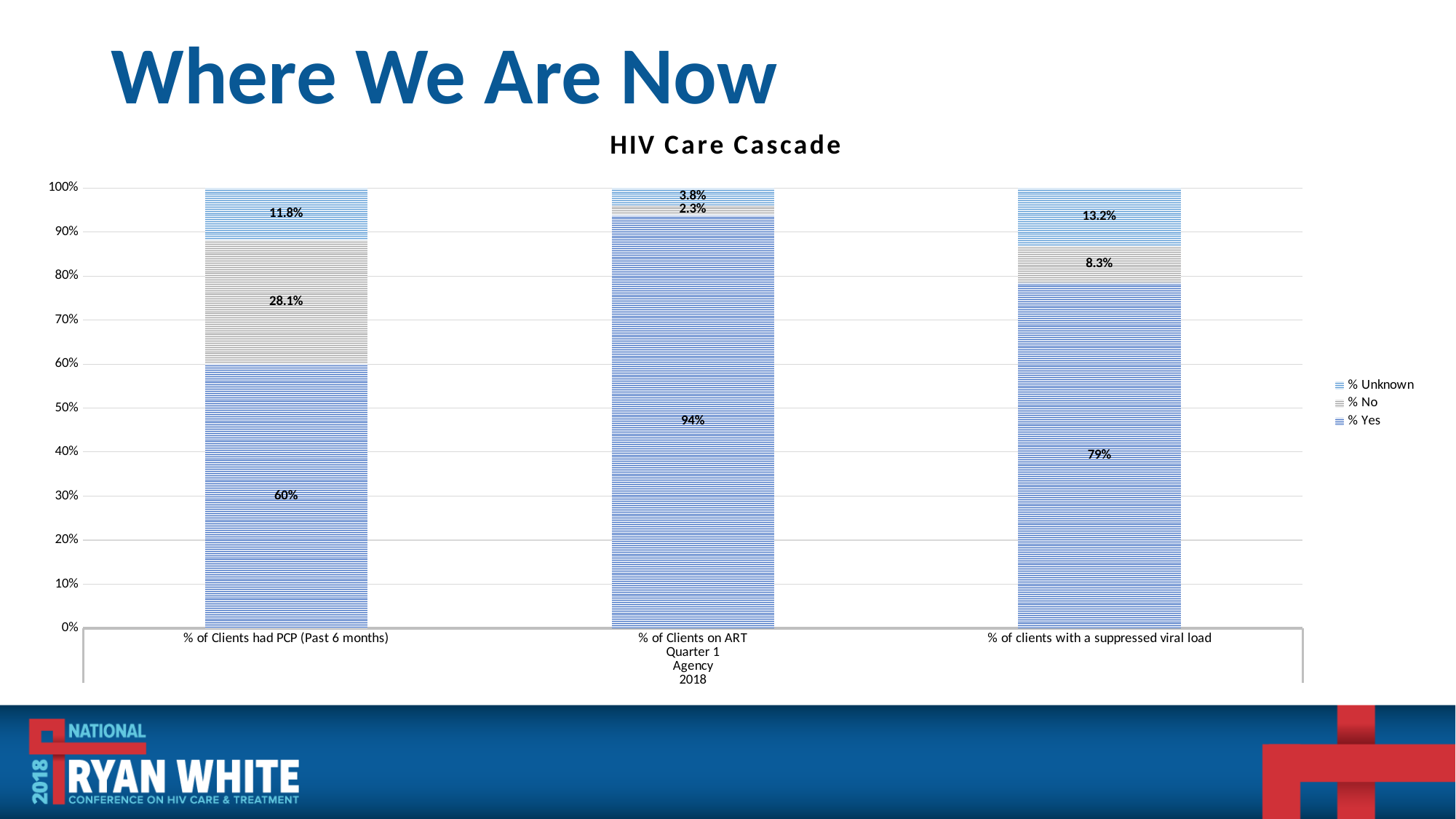
What is the % Unknown value for '% of clients with a suppressed viral load'? 13.2% How many categories are shown on the x axis? 3 What is the difference between the % Yes values for '% of Clients on ART' and '% of Clients had PCP (Past 6 months)'? 34% What is the title of the chart? HIV Care Cascade What is the % Yes value for '% of Clients on ART'? 94% Which category has the highest % Yes value? % of Clients on ART Which is larger: the % No value for '% of clients with a suppressed viral load' or the % No value for '% of Clients had PCP (Past 6 months)'? % of Clients had PCP (Past 6 months) Which category has the lowest % No value? % of Clients on ART How many series does the legend list? 3 What is the % No value for '% of Clients had PCP (Past 6 months)'? 28.1% What kind of chart is shown on the slide? stacked bar chart What is the % Unknown value for '% of Clients on ART'? 3.8%